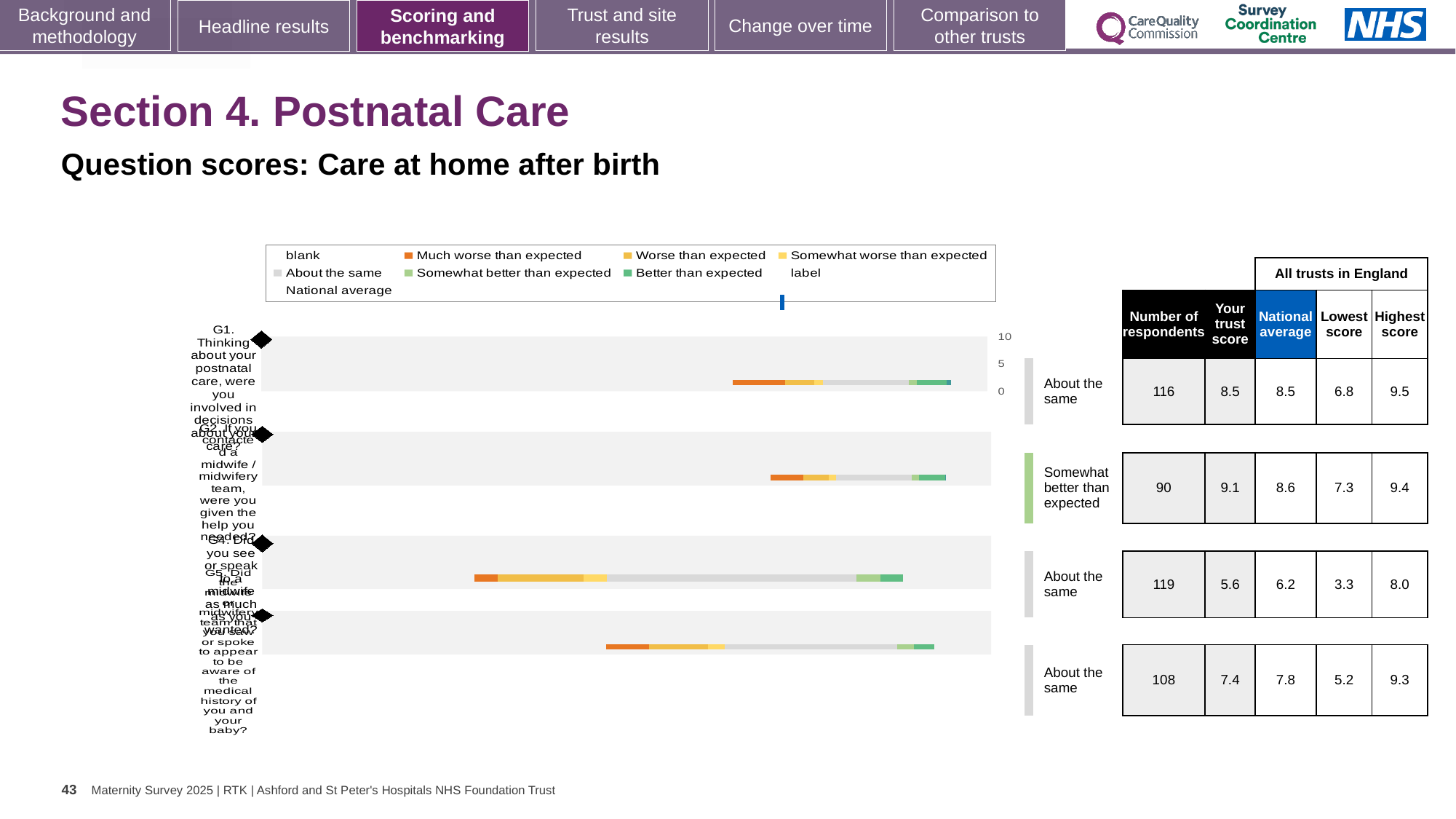
What is the national average for question G2 (given the help you needed when contacting a midwife)? 8.6 What is the trust score for question G1 (involved in decisions about postnatal care)? 8.5 Which question has the highest trust score? G2 What is the difference between the national average and the trust score for question G4? 0.6 Which question has the lowest trust score? G4 How many questions (rows) are plotted in the chart? 4 What kind of chart is used to show the question scores on this slide? bar chart How many respondents answered question G4 (seeing a midwife as much as you wanted)? 119 What is the lowest score among all trusts in England for question G5 (midwife aware of medical history)? 5.2 How many entries does the chart legend list? 9 Is the trust score for question G2 higher or lower than the national average for that question? higher Which question is rated 'Somewhat better than expected'? G2